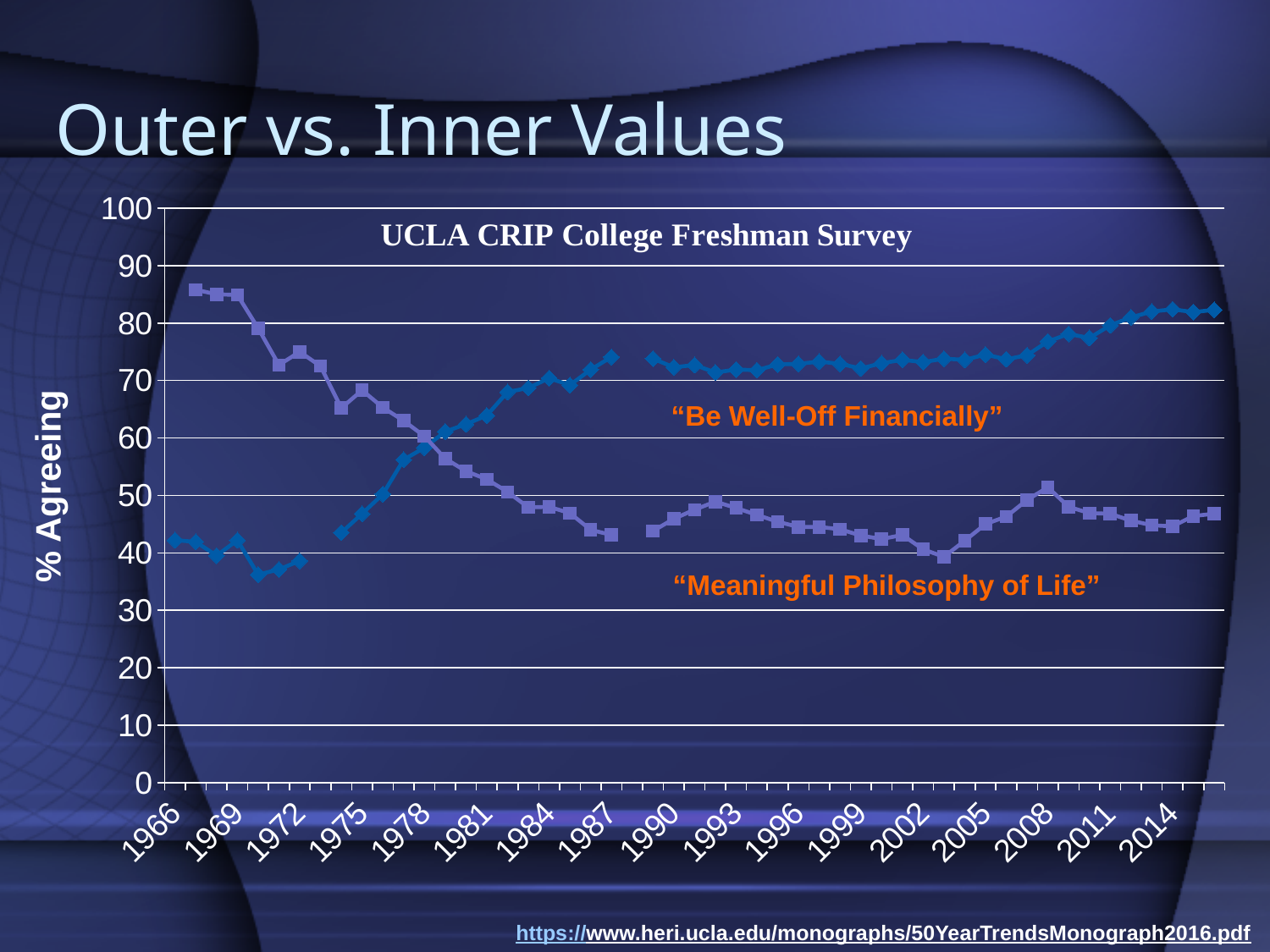
What is the title printed inside the chart? UCLA CRIP College Freshman Survey Overall, does the "Meaningful Philosophy of Life" series rise or fall from 1966 to 2014? fall What kind of chart is shown on the slide? line chart How many data series are plotted on the chart? 2 Is the value for "Be Well-Off Financially" in 1990 greater or less than 70? greater Is the value for "Be Well-Off Financially" in 1966 greater or less than 50? less Is the value for "Meaningful Philosophy of Life" in 2014 greater or less than 50? less Which series has the higher value in 2014, "Be Well-Off Financially" or "Meaningful Philosophy of Life"? Be Well-Off Financially What is the label on the vertical axis of the chart? % Agreeing